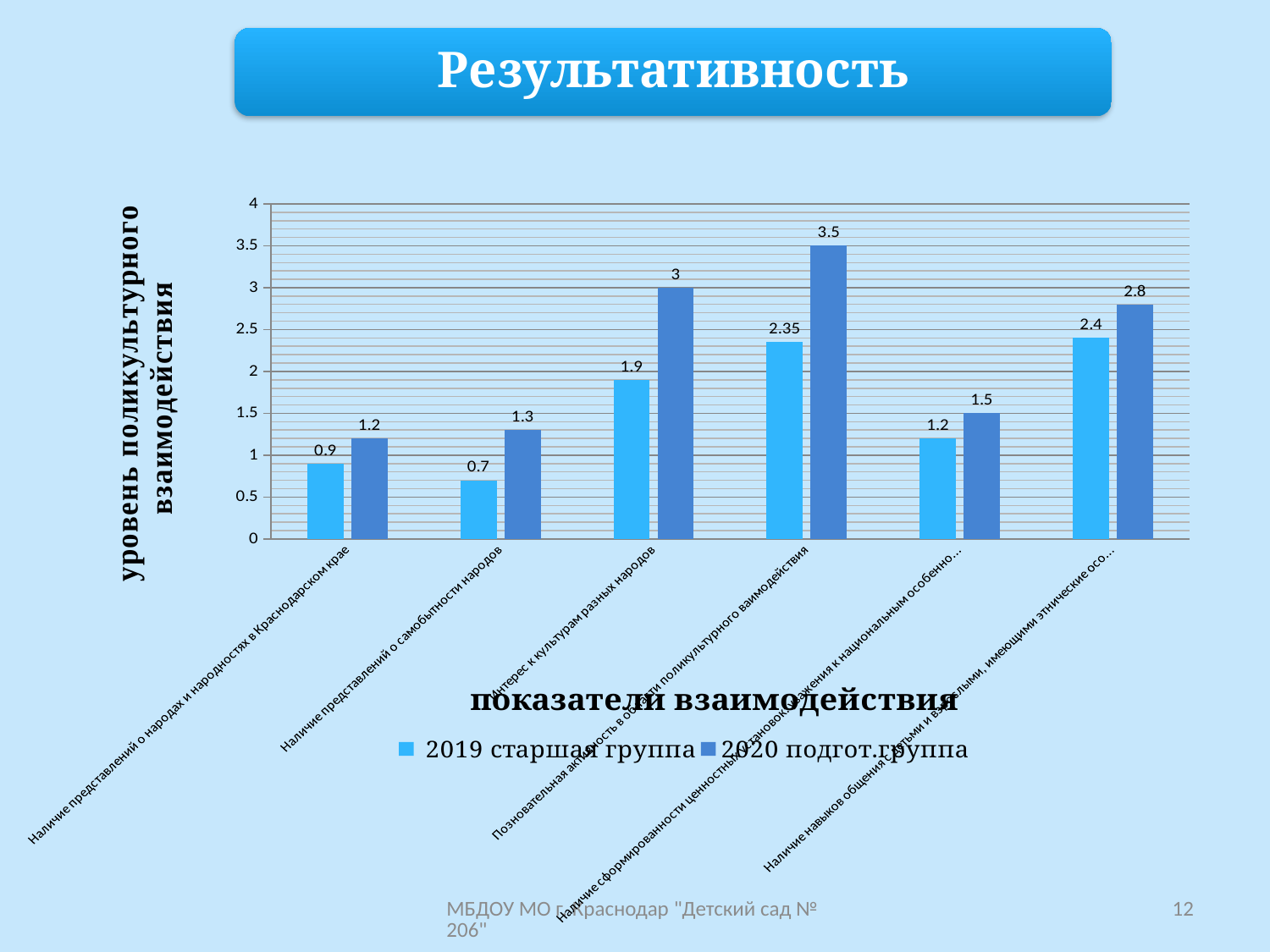
Which category has the lowest value for the "2019 старшая группа" series? Наличие представлений о самобытности народов What kind of chart is shown on the slide? bar chart What is the title of the vertical axis of the chart? уровень поликультурного взаимодействия How many categories are shown on the x axis of the chart? 6 How many series does the chart legend list? 2 Which category has the highest value for the "2020 подгот.группа" series? Позновательная активность в области поликультурного ваимодействия What is the value for "2019 старшая группа" in the category "Наличие представлений о народах и народностях в Краснодарском крае"? 0.9 Is the highest value for "2020 подгот.группа" greater or less than 3? greater What is the difference between the 2020 and 2019 values in the category "Интерес к культурам разных народов"? 1.1 What is the value for "2020 подгот.группа" in the category "Наличие представлений о самобытности народов"? 1.3 What is the value for "2019 старшая группа" in the category "Интерес к культурам разных народов"? 1.9 In the category "Наличие представлений о самобытности народов", which series has the larger value, 2019 старшая группа or 2020 подгот.группа? 2020 подгот.группа